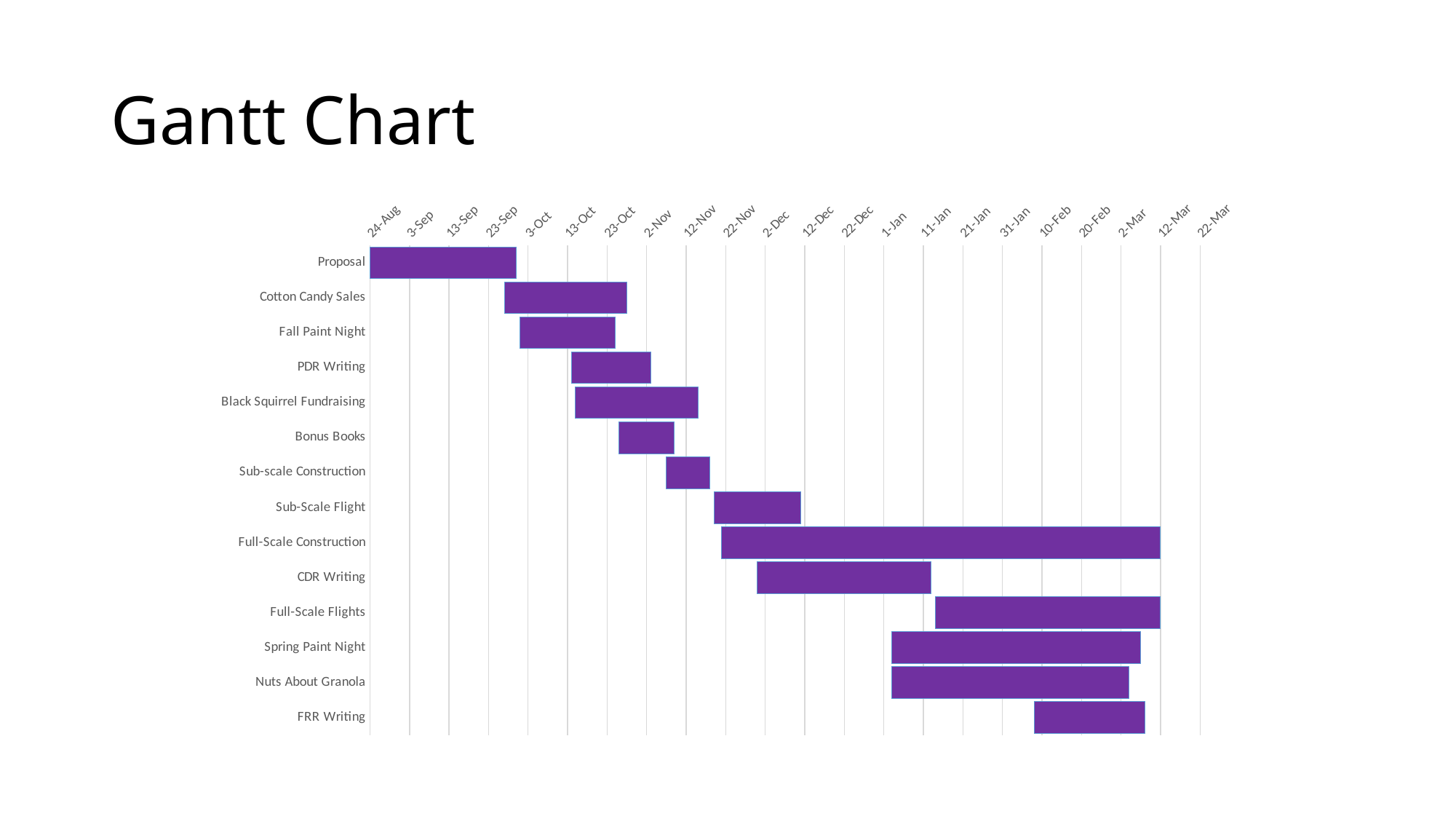
How many tasks are listed on the vertical axis of the Gantt chart? 14 Which task's bar starts earliest on the timeline? Proposal What is the title of the slide? Gantt Chart Does the Sub-Scale Flight bar start before or after 12-Nov? after Which task's bar starts latest on the timeline? FRR Writing Which task has the longest bar in the Gantt chart? Full-Scale Construction Does the Full-Scale Construction bar extend past 2-Mar? Yes Which bar is longer, Full-Scale Flights or CDR Writing? Full-Scale Flights What kind of chart is shown on the slide? Bar chart (Gantt chart) Does the Proposal bar end before or after 3-Oct? before Which task has the shortest bar in the Gantt chart? Sub-scale Construction Which bar is longer, Cotton Candy Sales or Fall Paint Night? Cotton Candy Sales